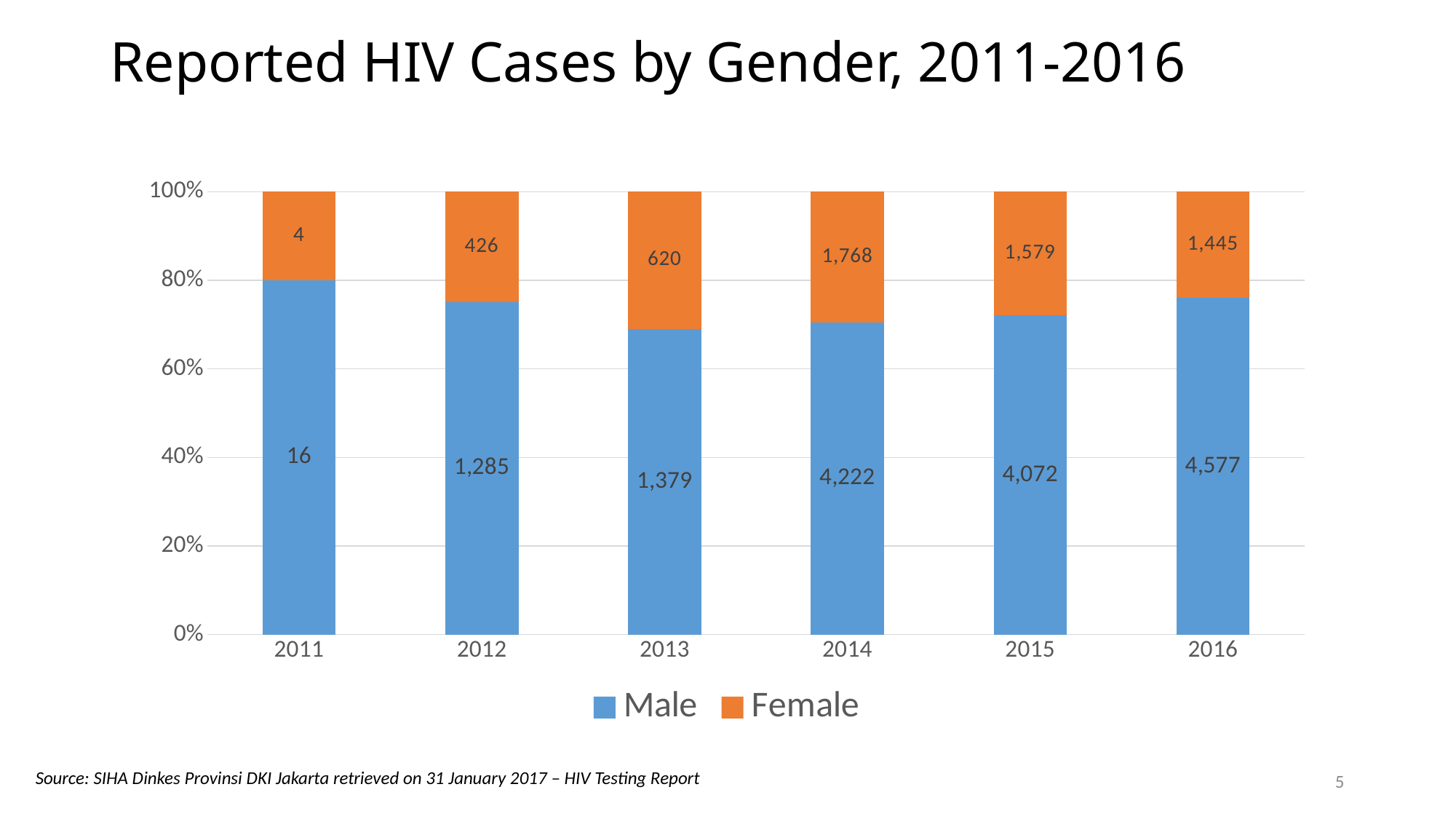
Which is larger, the number of female cases in 2014 or in 2015? 2014 How many years are shown on the x axis? 6 How many series does the legend list? 2 What is the difference between male and female HIV cases in 2015? 2,493 Is the male share of reported cases in 2013 greater or less than 80%? less What is the total number of reported HIV cases (male plus female) in 2012? 1,711 Which year has the lowest number of female HIV cases? 2011 Which year has the highest number of male HIV cases? 2016 What is the number of female HIV cases reported in 2012? 426 What is the number of male HIV cases reported in 2014? 4,222 What is the number of female HIV cases reported in 2016? 1,445 What kind of chart is shown on the slide? Stacked bar chart